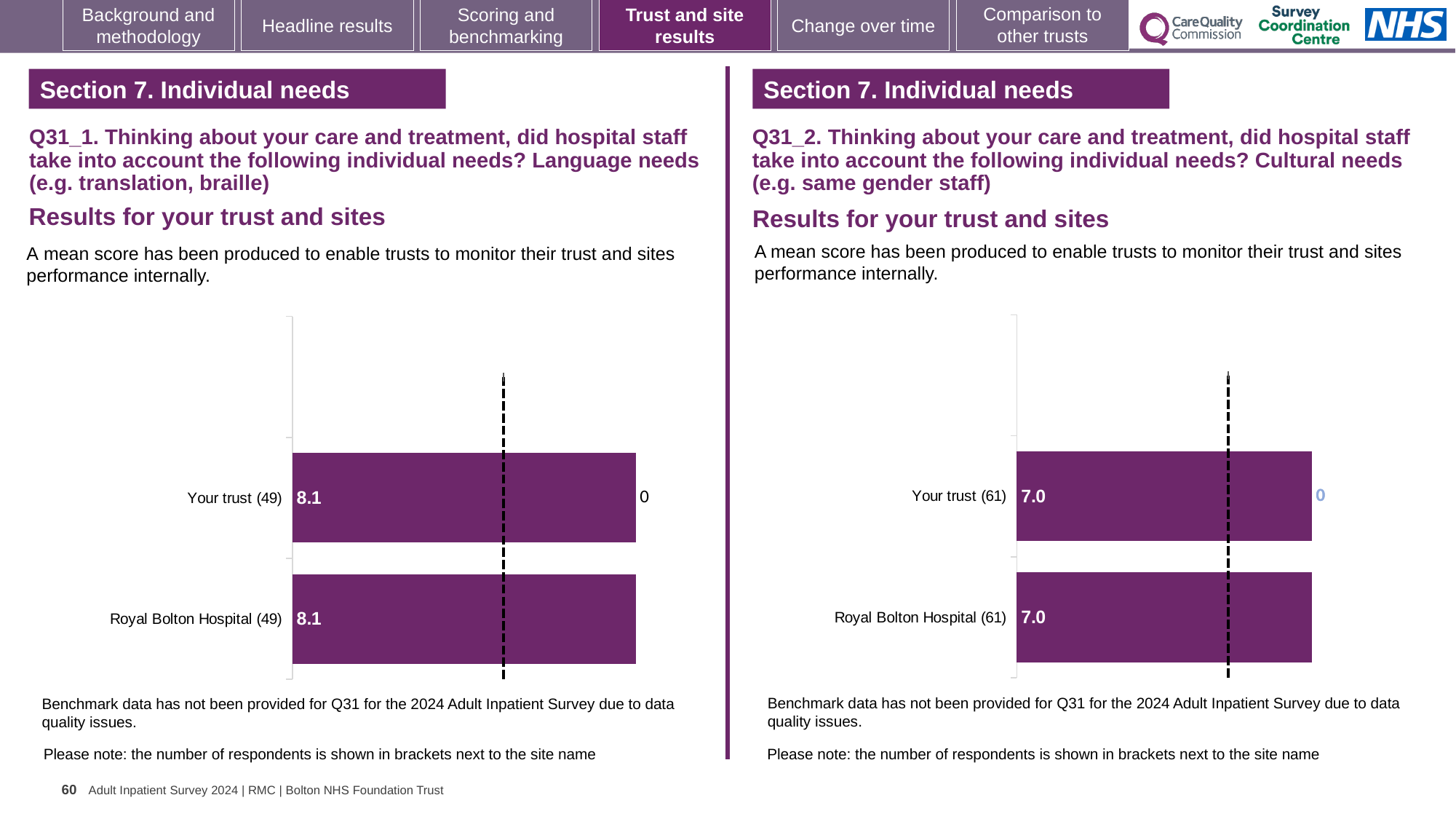
In the left chart (Q31_1, Language needs), what is the difference between the scores for Your trust and Royal Bolton Hospital? 0.0 In the right chart (Q31_2, Cultural needs), how many respondents are shown in brackets for Your trust? 61 How many bars are plotted in the right chart (Q31_2, Cultural needs)? 2 In the right chart (Q31_2, Cultural needs), what is the difference between the scores for Your trust and Royal Bolton Hospital? 0.0 In the right chart (Q31_2, Cultural needs), what is the mean score for Your trust? 7.0 Is the Your trust score in the left chart (Q31_1) larger or smaller than the Your trust score in the right chart (Q31_2)? Larger In the left chart (Q31_1, Language needs), how many respondents are shown in brackets for Royal Bolton Hospital? 49 In the left chart (Q31_1, Language needs), what is the mean score for Royal Bolton Hospital? 8.1 How many bars are plotted in the left chart (Q31_1, Language needs)? 2 In the left chart (Q31_1, Language needs), what is the mean score for Your trust? 8.1 What type of chart is used in the left chart (Q31_1, Language needs)? Bar chart In the right chart (Q31_2, Cultural needs), what is the mean score for Royal Bolton Hospital? 7.0